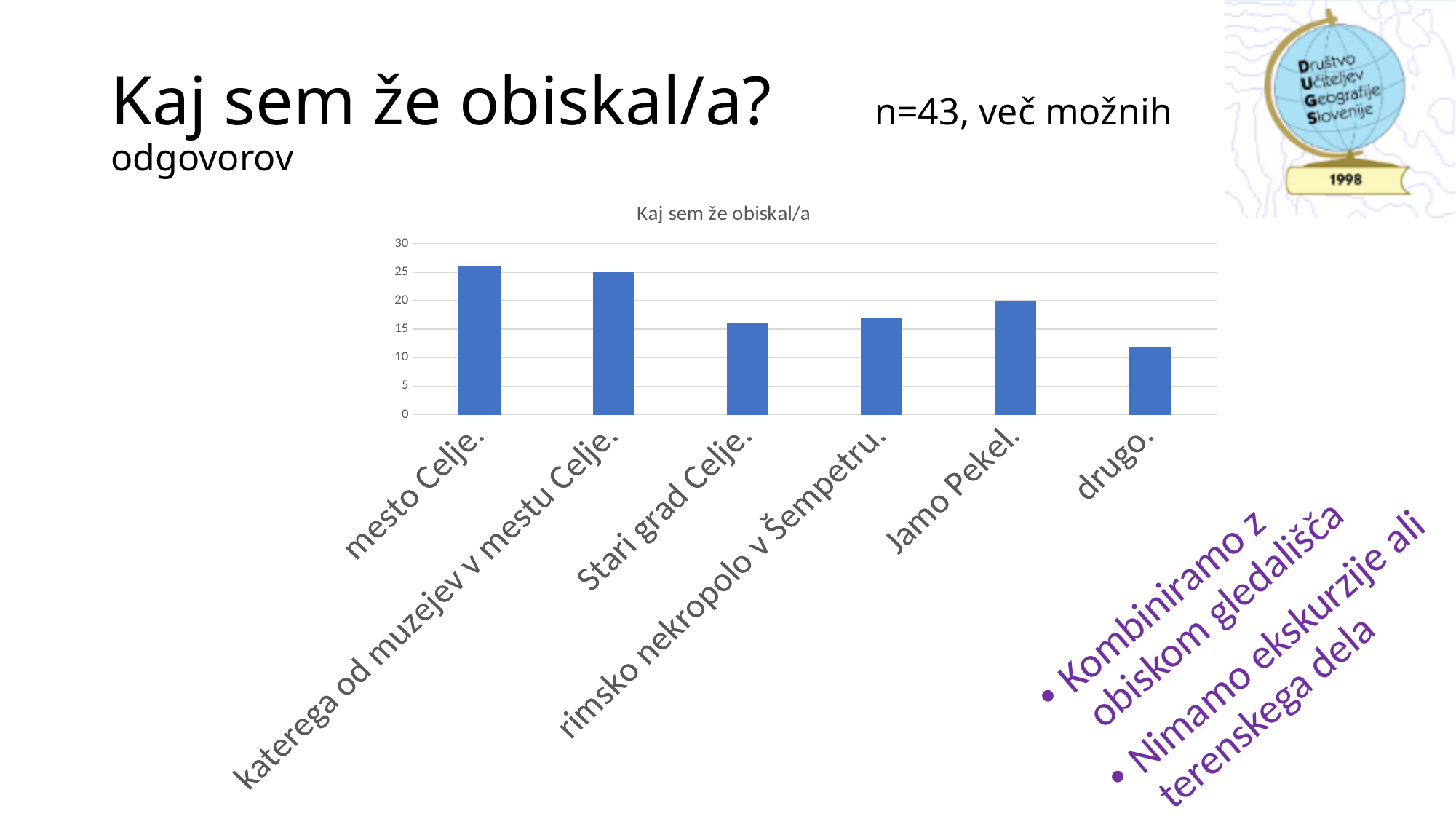
Which category has the lowest value? drugo What is the title of the chart? Kaj sem že obiskal/a What kind of chart is shown on the slide? bar chart Which is larger, the value for Jamo Pekel or the value for drugo? Jamo Pekel What is the value for katerega od muzejev v mestu Celje? 25 Is the value for drugo greater or less than 15? less How many categories are shown on the x axis of the chart? 6 Which category has the highest value? mesto Celje Is the value for rimsko nekropolo v Šempetru greater or less than 20? less What is the value for Jamo Pekel? 20 Is the value for mesto Celje greater or less than 25? greater